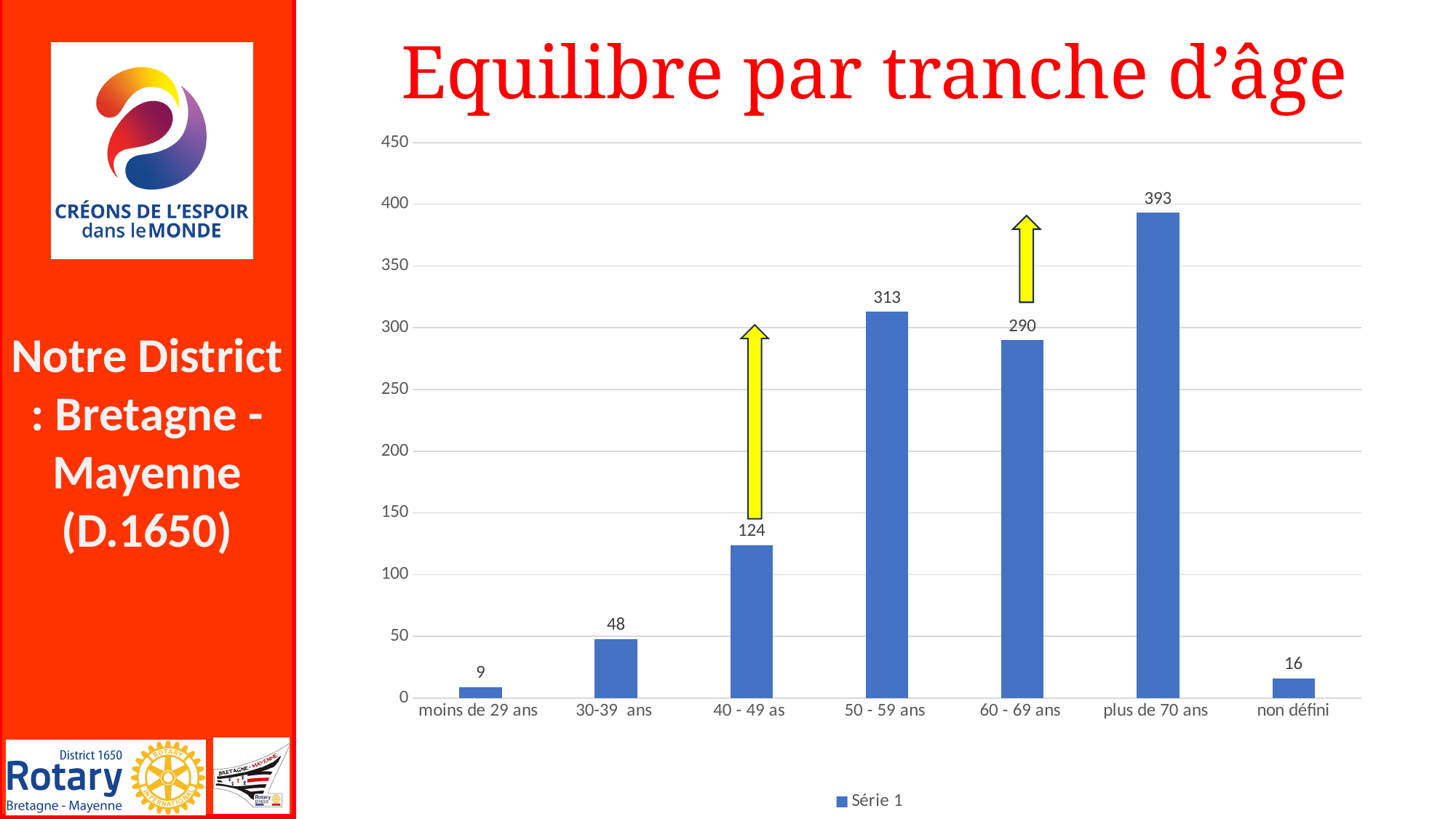
What is the value for the 'non défini' category? 16 How many categories are shown on the x axis? 7 What is the value for the '50 - 59 ans' category? 313 What is the difference between the values for 'plus de 70 ans' and '60 - 69 ans'? 103 Which category has the lowest value? moins de 29 ans What kind of chart is shown on the slide? bar chart What is the title of the chart? Equilibre par tranche d’âge How many series does the legend list? 1 Which is larger, the value for '40 - 49 as' or the value for '30-39 ans'? 40 - 49 as Which category has the highest value? plus de 70 ans What is the value for the 'moins de 29 ans' category? 9 Is the value for '60 - 69 ans' greater or less than 300? less